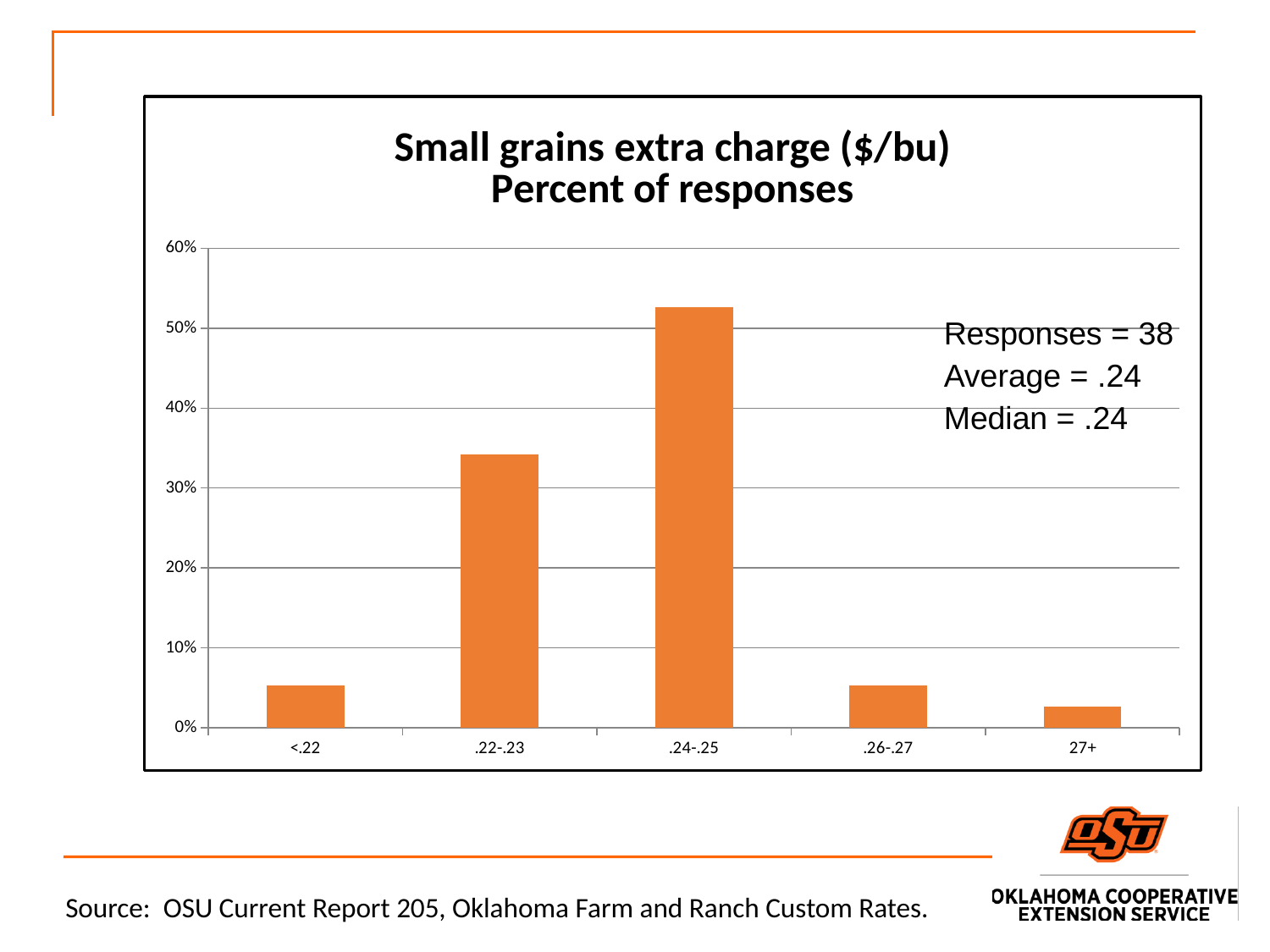
How many categories are shown on the x axis of the chart? 5 Which has a higher percent of responses, .22-.23 or .24-.25? .24-.25 Which category has the highest percent of responses? .24-.25 Is the value for .24-.25 greater or less than 50%? greater What kind of chart is shown on the slide? bar chart Is the value for <.22 greater or less than 10%? less According to the text on the chart, how many responses were there? 38 Which has a higher percent of responses, .22-.23 or .26-.27? .22-.23 Do the values rise or fall from .24-.25 to 27+ along the x axis? fall Is the value for 27+ greater or less than 10%? less Which category has the lowest percent of responses? 27+